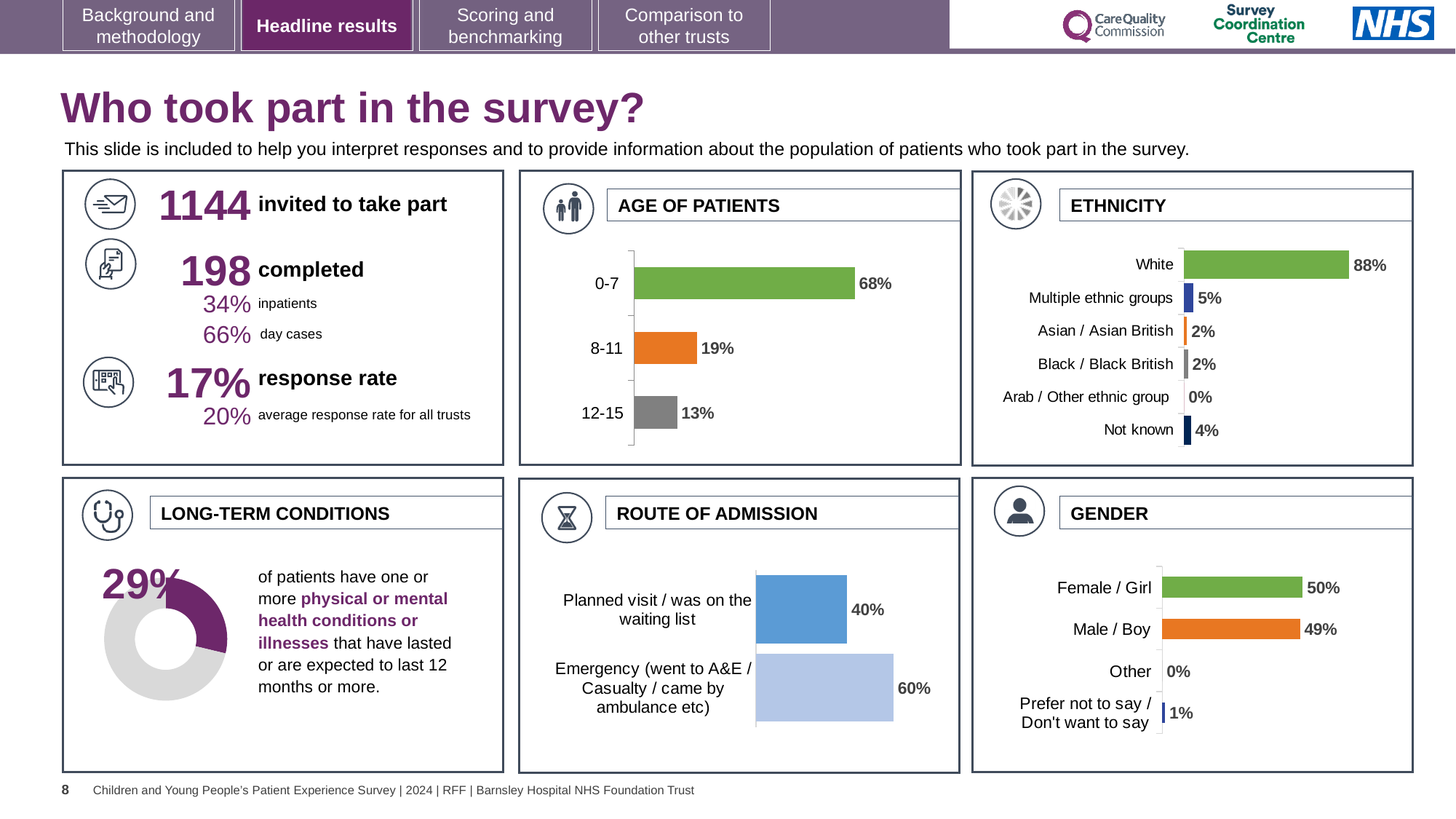
In the ROUTE OF ADMISSION chart, which route has the larger percentage, Planned visit / was on the waiting list or Emergency? Emergency (went to A&E / Casualty / came by ambulance etc) In the AGE OF PATIENTS chart, which age group has the lowest percentage? 12-15 In the AGE OF PATIENTS chart, what is the difference between the 8-11 and 12-15 percentages? 6% What kind of chart is used in the LONG-TERM CONDITIONS panel? Doughnut chart In the ROUTE OF ADMISSION chart, what is the difference between the Emergency and Planned visit percentages? 20% In the ETHNICITY chart, what percentage of patients were White? 88% In the AGE OF PATIENTS chart, what percentage of patients were aged 0-7? 68% In the GENDER chart, what is the value for Prefer not to say / Don't want to say? 1% In the GENDER chart, what percentage of patients were Male / Boy? 49% In the ETHNICITY chart, how many ethnic categories are shown? 6 In the ETHNICITY chart, what is the value for Not known? 4% In the LONG-TERM CONDITIONS chart, what percentage of patients have one or more long-term conditions? 29%